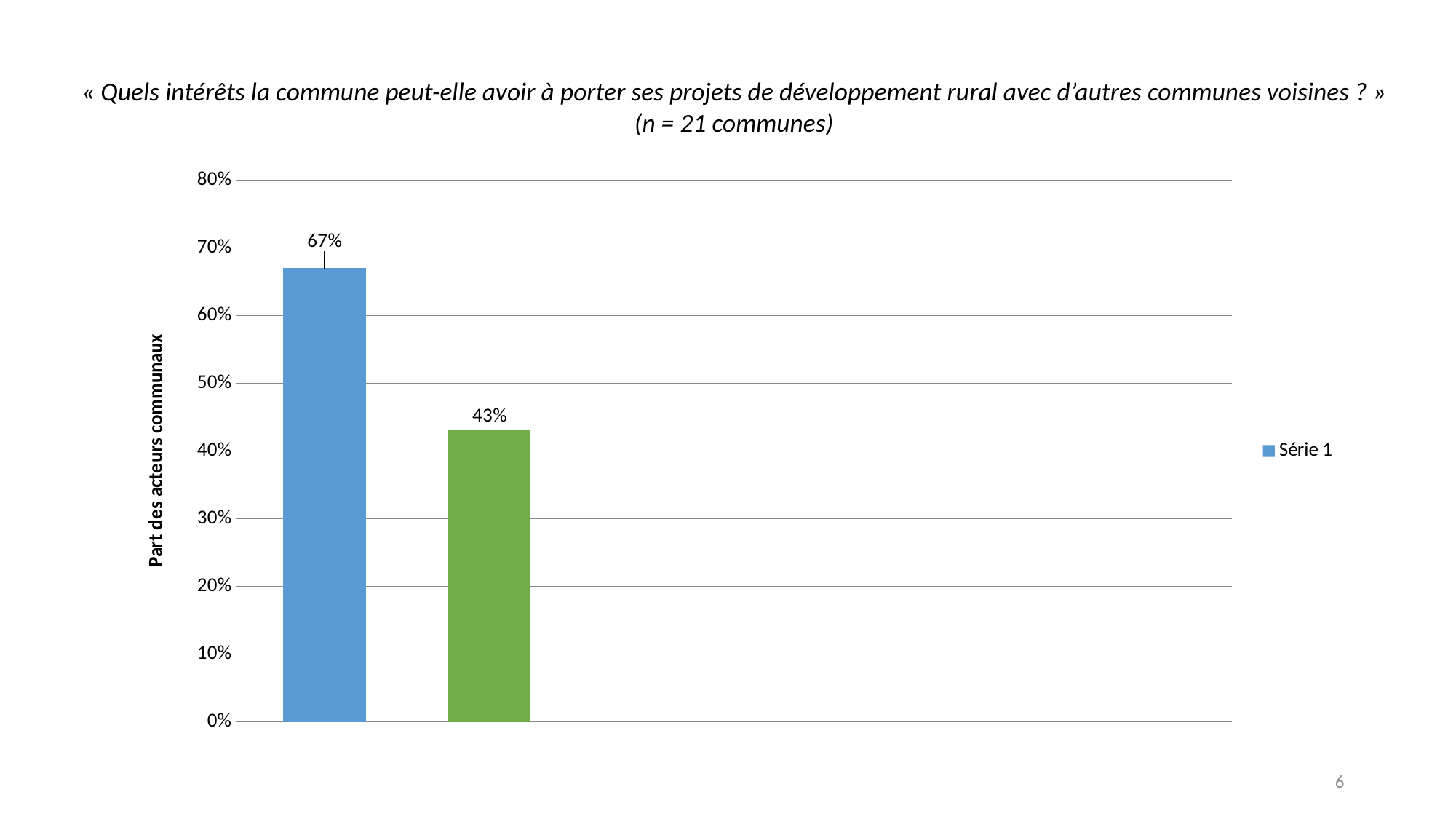
How many bars are plotted in the chart? 2 Which bar is higher, the blue one or the green one? the blue one What is the name of the series shown in the legend? Série 1 What is the value of the green (right) bar? 43% What is the highest value shown on the y axis? 80% Is the value of the blue bar greater or less than 60%? greater What is the value of the blue (left) bar? 67% What is the difference between the blue bar and the green bar? 24% Is the value of the green bar greater or less than 50%? less What kind of chart is shown on the slide? bar chart What is the label of the y axis? Part des acteurs communaux How many series does the legend list? 1